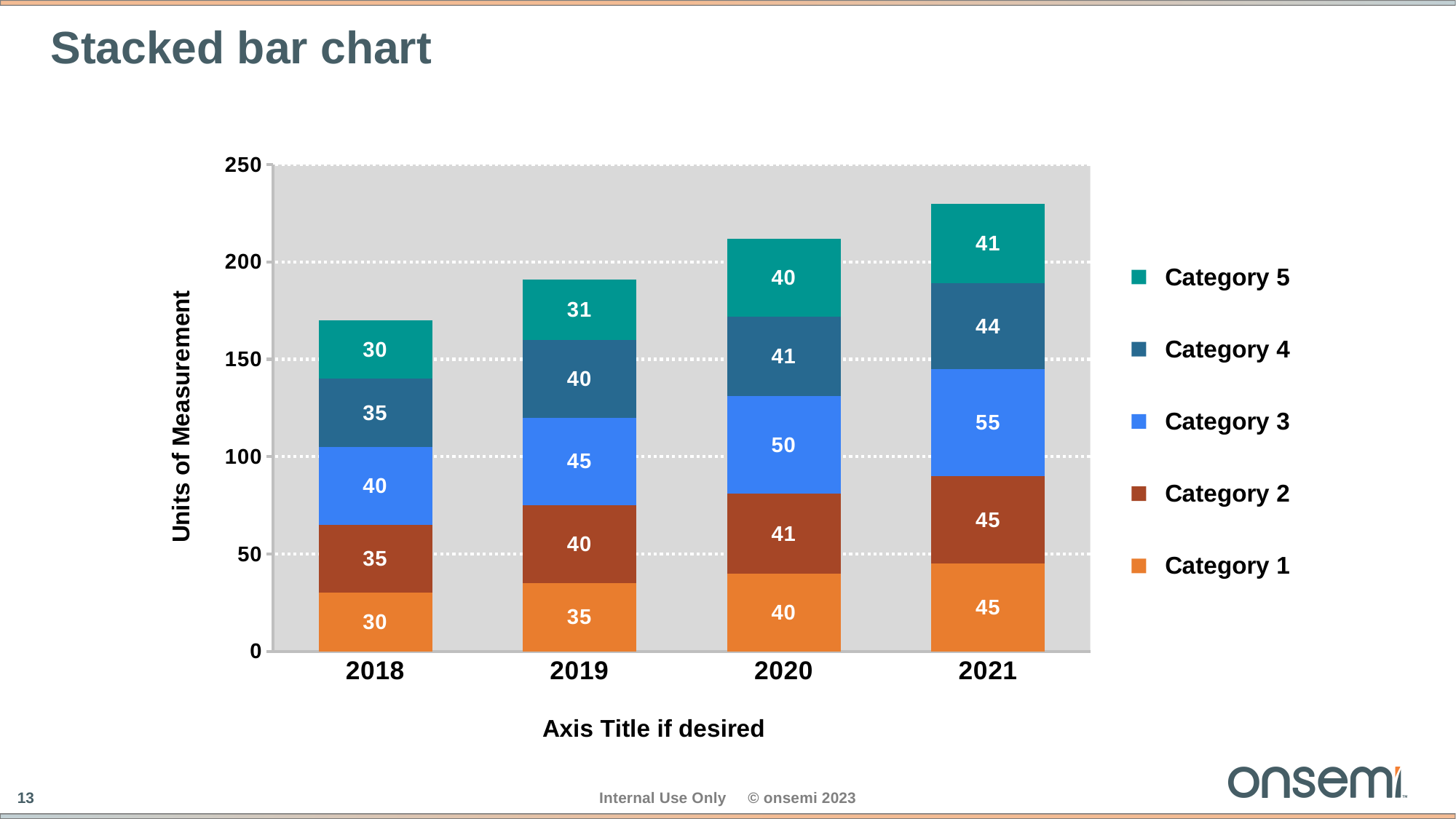
Which is larger: Category 4 in 2019 or Category 4 in 2021? Category 4 in 2021 What is the difference between the Category 3 values for 2021 and 2018? 25 How many series does the legend list? 5 What is the value for Category 3 in 2020? 50 How many years are shown on the x axis? 4 Which year has the lowest value for Category 1? 2018 What is the total of the stacked bar for 2018? 170 What is the value for Category 1 in 2021? 45 What kind of chart is shown on the slide? Stacked bar chart What is the total of the stacked bar for 2021? 230 What is the value for Category 5 in 2019? 31 Which year has the highest value for Category 3? 2021